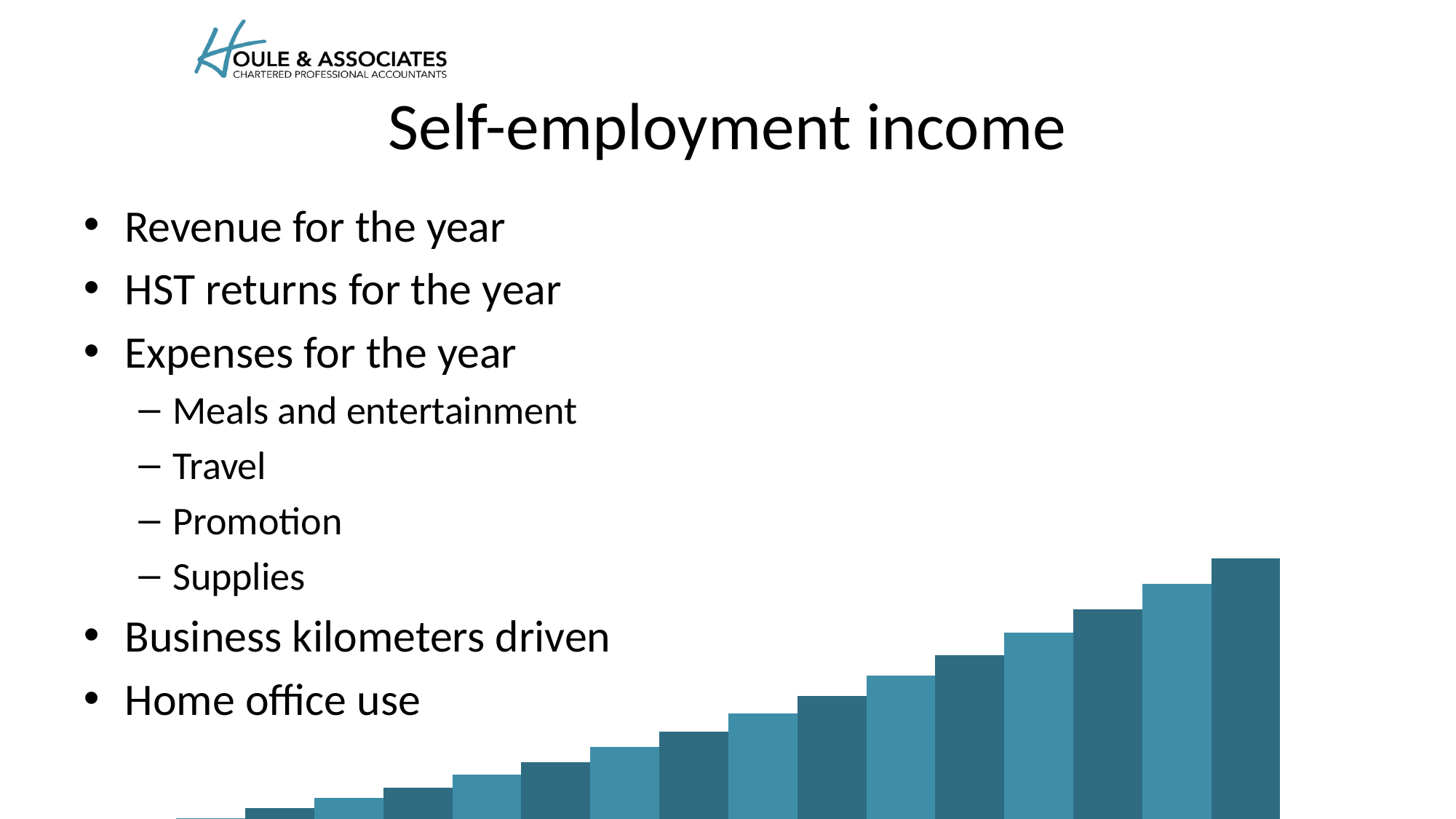
Which bar in the chart at the bottom right of the slide is the tallest, the leftmost or the rightmost? the rightmost What kind of chart is shown at the bottom right of the slide? bar chart How many different shades are used for the bars in the chart at the bottom right of the slide? 2 Do the bars in the chart at the bottom right of the slide rise or fall from left to right? rise Does the chart at the bottom right of the slide show any axis labels or data labels? No